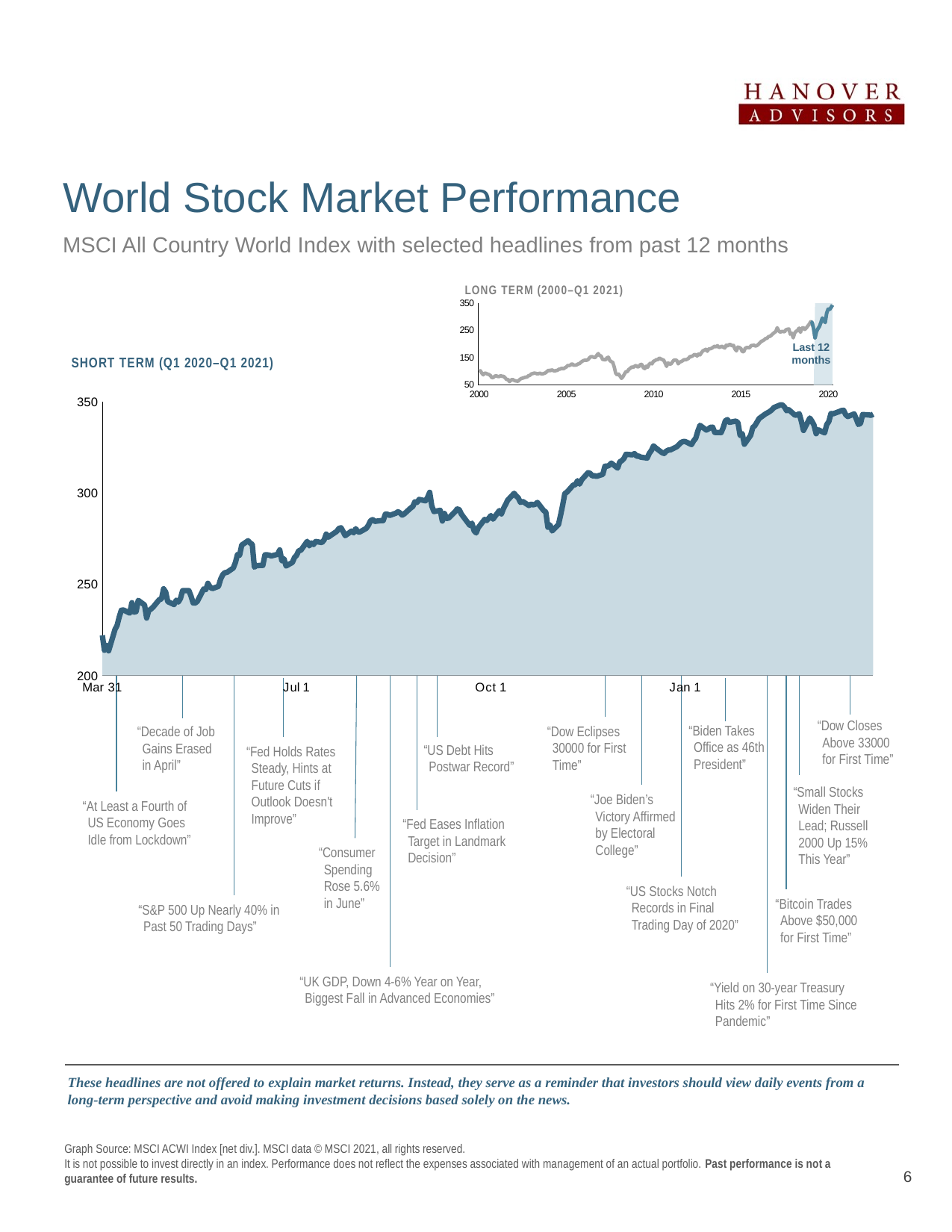
What kind of chart is the LONG TERM (2000–Q1 2021) chart? line chart In the LONG TERM (2000–Q1 2021) chart, do the values generally rise or fall from 2000 to 2020? rise In the SHORT TERM (Q1 2020–Q1 2021) chart, is the value at Mar 31 greater or less than 250? less In the LONG TERM (2000–Q1 2021) chart, is the value at 2020 greater or less than 150? greater In the SHORT TERM (Q1 2020–Q1 2021) chart, which is larger, the value at Mar 31 or the value at Jan 1? Jan 1 In the SHORT TERM (Q1 2020–Q1 2021) chart, is the value at Jul 1 greater or less than 250? greater How many date labels are shown on the x axis of the SHORT TERM (Q1 2020–Q1 2021) chart? 4 What kind of chart is the SHORT TERM (Q1 2020–Q1 2021) chart? line chart What label is given to the shaded region at the right end of the LONG TERM (2000–Q1 2021) chart? Last 12 months In the SHORT TERM (Q1 2020–Q1 2021) chart, do the values generally rise or fall from Mar 31 to the end of the period? rise